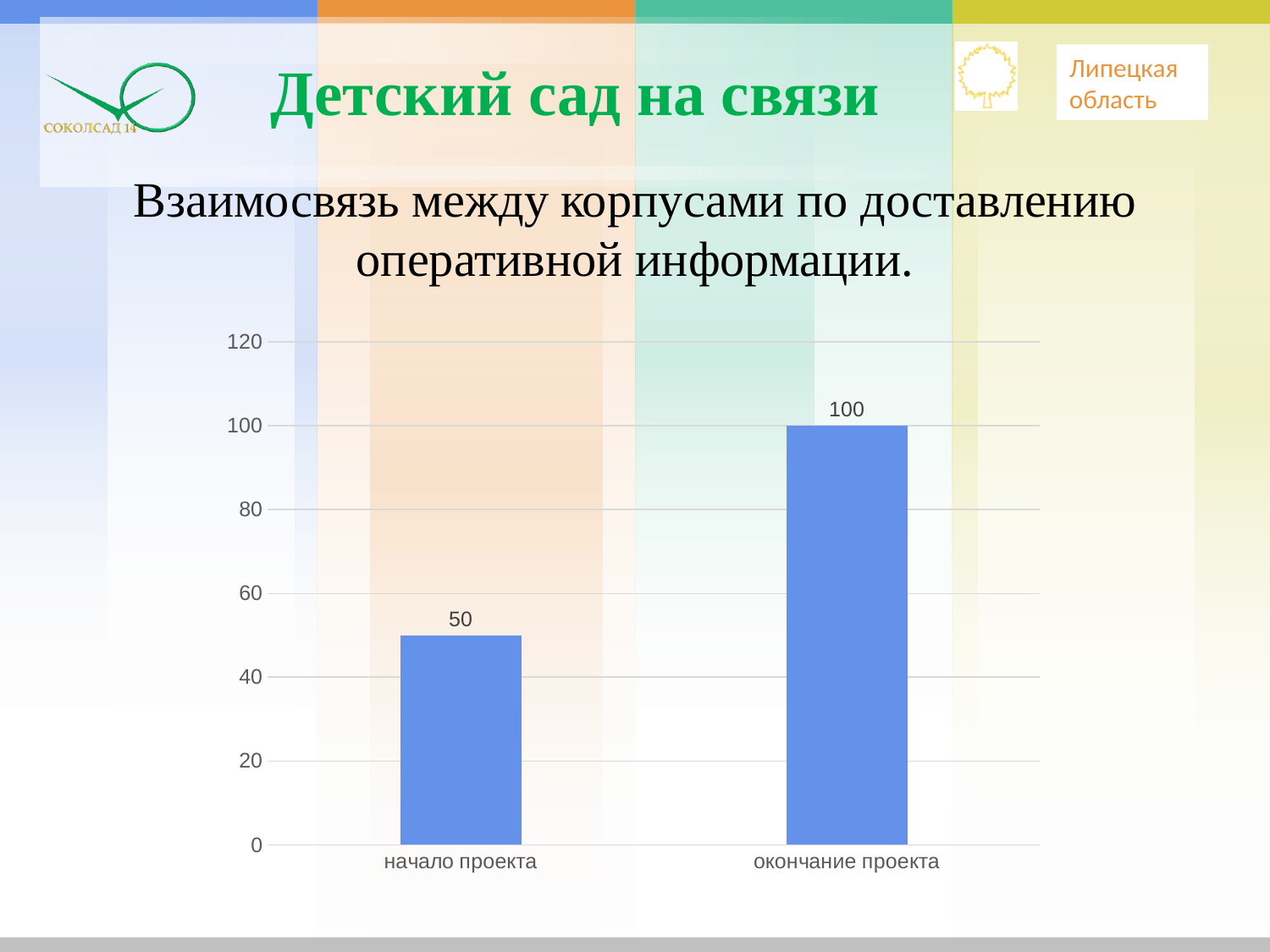
What is the difference between the values for окончание проекта and начало проекта? 50 Is the value for начало проекта greater or less than 60? less How many categories are shown on the x axis? 2 Is the value for окончание проекта greater or less than 80? greater Which category has the highest value? окончание проекта What is the value for окончание проекта? 100 Which category has the lowest value? начало проекта Which is larger, the value for начало проекта or the value for окончание проекта? окончание проекта What is the value for начало проекта? 50 What kind of chart is shown on the slide? bar chart What is the highest value shown on the vertical axis? 120 Do the values rise or fall from начало проекта to окончание проекта? rise